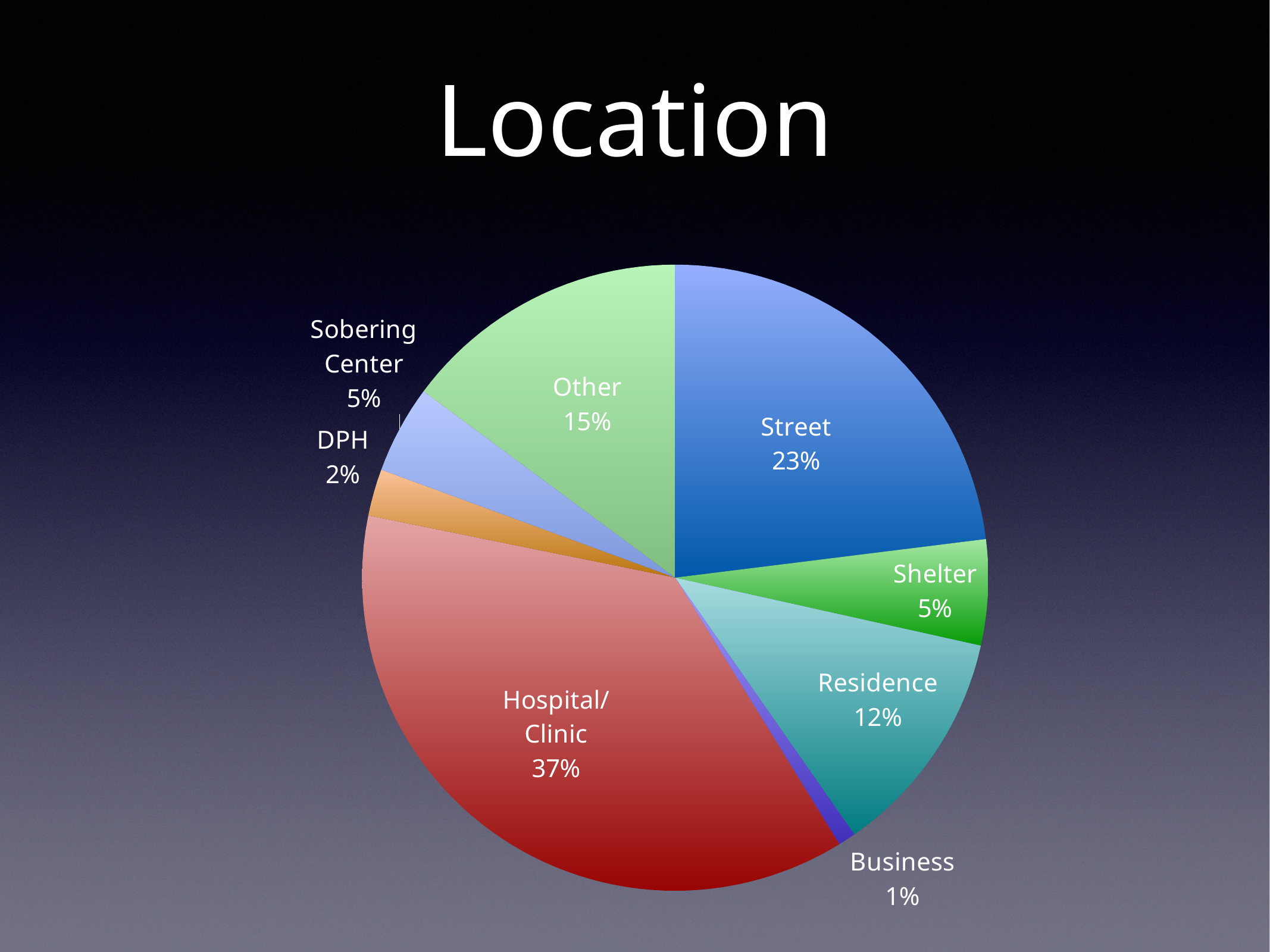
What percentage does the DPH slice represent? 2% What is the title of the chart? Location What percentage does the Street slice represent? 23% What percentage does the Residence slice represent? 12% What type of chart is shown on the slide? pie chart What is the combined percentage of the Shelter and Sobering Center slices? 10% Which is larger, the Other slice or the Residence slice? Other Which location has the smallest share of the pie? Business What is the difference in percentage points between Hospital/Clinic and Street? 14 What percentage does the Hospital/Clinic slice represent? 37% How many slices does the pie chart have? 8 Which location has the largest share of the pie? Hospital/Clinic